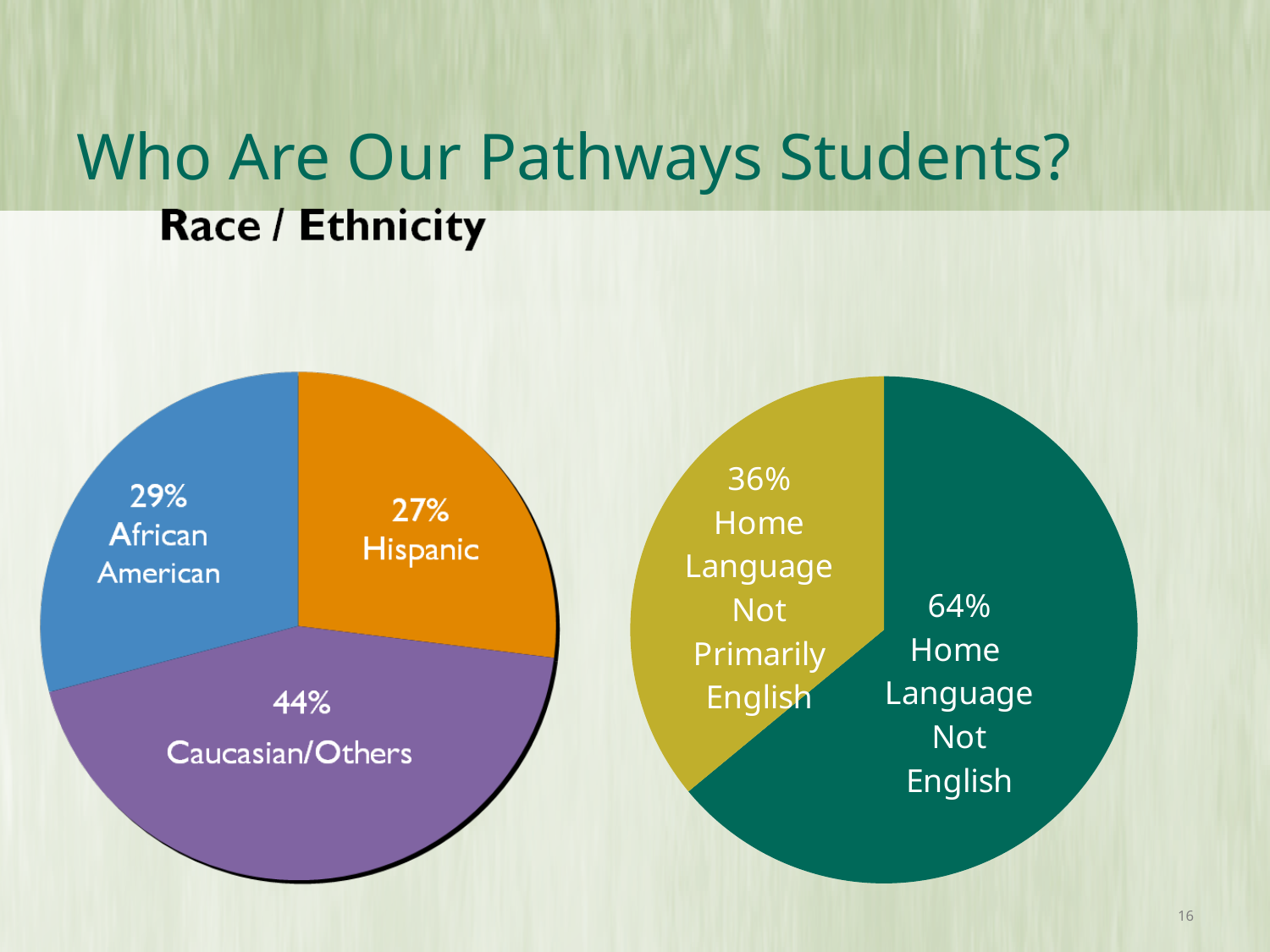
In the pie chart on the right, which slice is larger: Home Language Not English or Home Language Not Primarily English? Home Language Not English In the pie chart on the right, what percentage of students have a home language that is not primarily English? 36% In the Race / Ethnicity pie chart on the left, what percentage of students are Hispanic? 27% In the pie chart on the right, what percentage of students have a home language that is not English? 64% In the Race / Ethnicity pie chart on the left, how many slices are there? 3 In the Race / Ethnicity pie chart on the left, which group has the smallest share? Hispanic In the Race / Ethnicity pie chart on the left, what percentage of students are African American? 29% In the Race / Ethnicity pie chart on the left, which group has the largest share? Caucasian/Others In the pie chart on the right, how many percentage points separate the two slices? 28 In the Race / Ethnicity pie chart on the left, what percentage of students are Caucasian/Others? 44% In the Race / Ethnicity pie chart on the left, how many percentage points larger is the Caucasian/Others share than the African American share? 15 What type of chart is used for the Race / Ethnicity data on the left? Pie chart